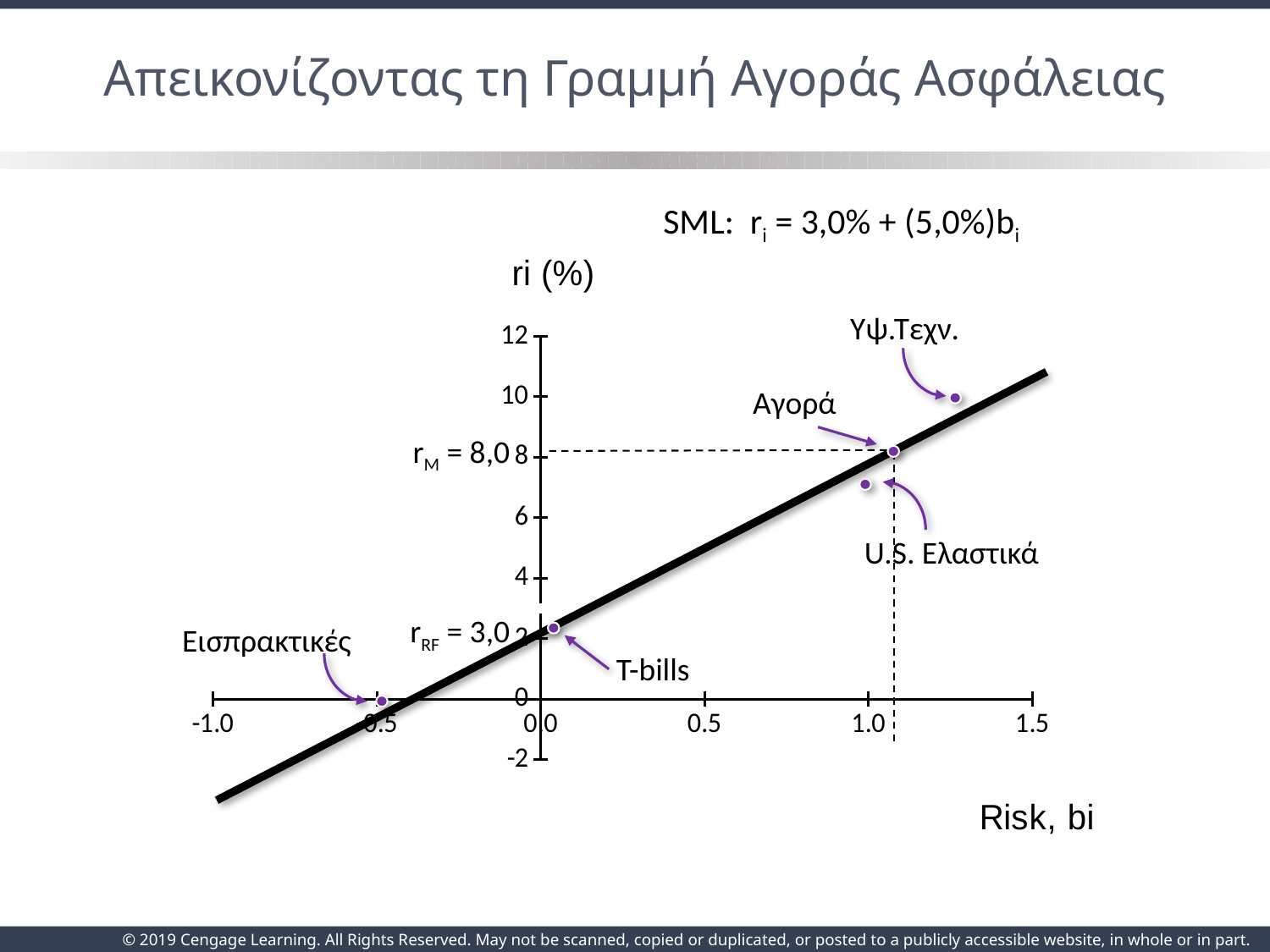
Does the SML line rise or fall as risk (bi) increases along the x axis? rise Which labelled point on the chart has the highest return? Υψ.Τεχν. Which has the higher return on the chart, Αγορά or U.S. Ελαστικά? Αγορά Is the return for Υψ.Τεχν. greater or less than 8? greater What is the risk-free return (r_RF) shown for T-bills on the chart? 3,0 Which labelled point on the chart has the lowest return? Εισπρακτικές What is the return value (r_M) shown for Αγορά on the chart? 8,0 How many labelled points are plotted on the chart? 5 Is the return for Εισπρακτικές greater or less than 2? less What is the difference between r_M and r_RF on the chart? 5,0 Is the return for U.S. Ελαστικά greater or less than 8? less What is the label of the horizontal axis of the chart? Risk, bi